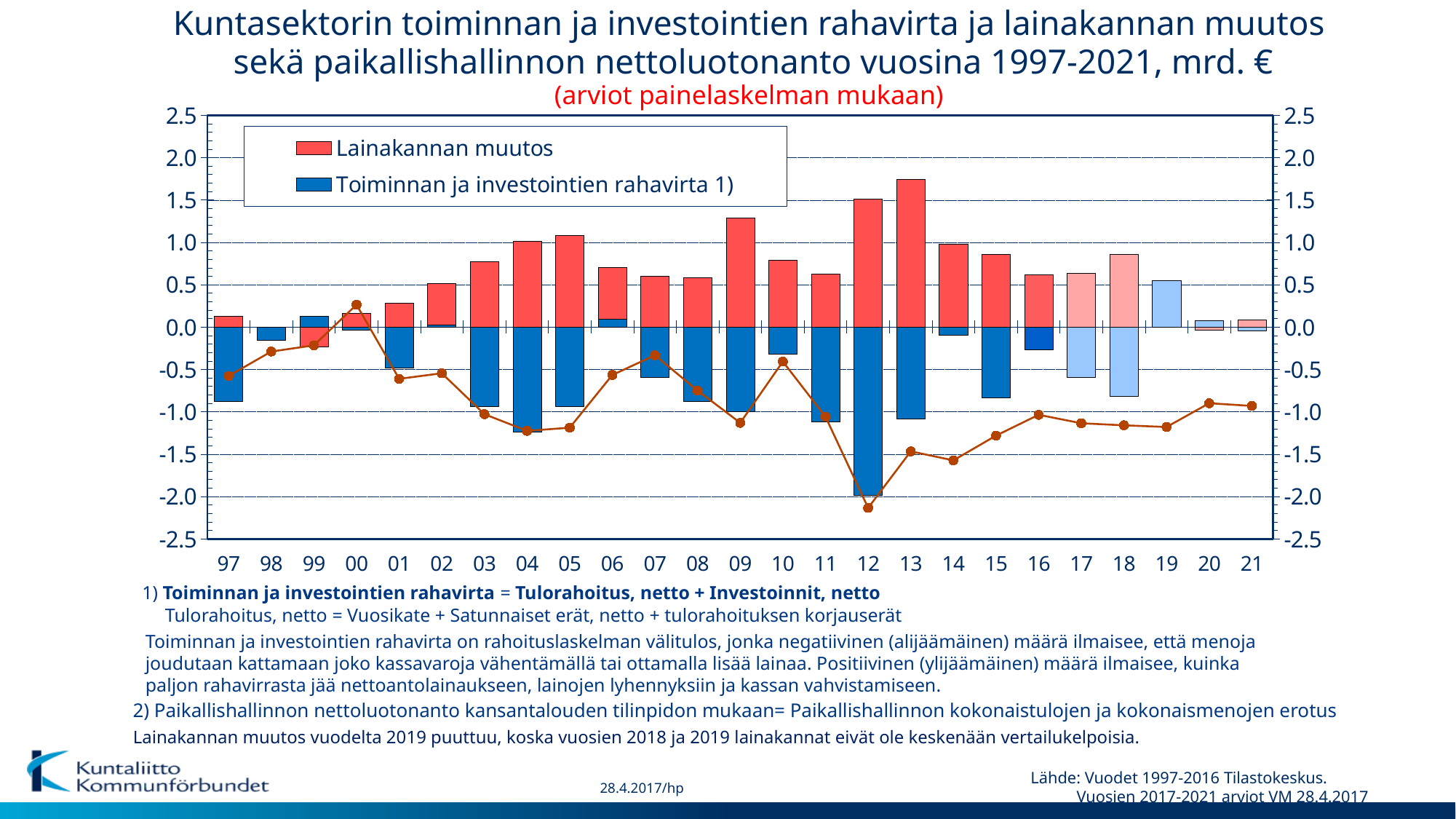
Is the Toiminnan ja investointien rahavirta value for 12 greater or less than -1.5? less Which year has the larger Lainakannan muutos bar, 09 or 10? 09 Which year has the lower Toiminnan ja investointien rahavirta bar, 12 or 13? 12 How many years are shown on the x axis? 25 Is the Lainakannan muutos value for 09 greater or less than 1.0? greater In which year is the Lainakannan muutos bar highest? 13 Is the Lainakannan muutos value for 13 greater or less than 1.5? greater What kind of chart is shown on the slide? Bar chart with a line How many series does the legend list? 2 In which year is the Toiminnan ja investointien rahavirta bar lowest? 12 Does the line series rise or fall from 10 to 12? Falls What is the maximum value shown on the y axis? 2.5